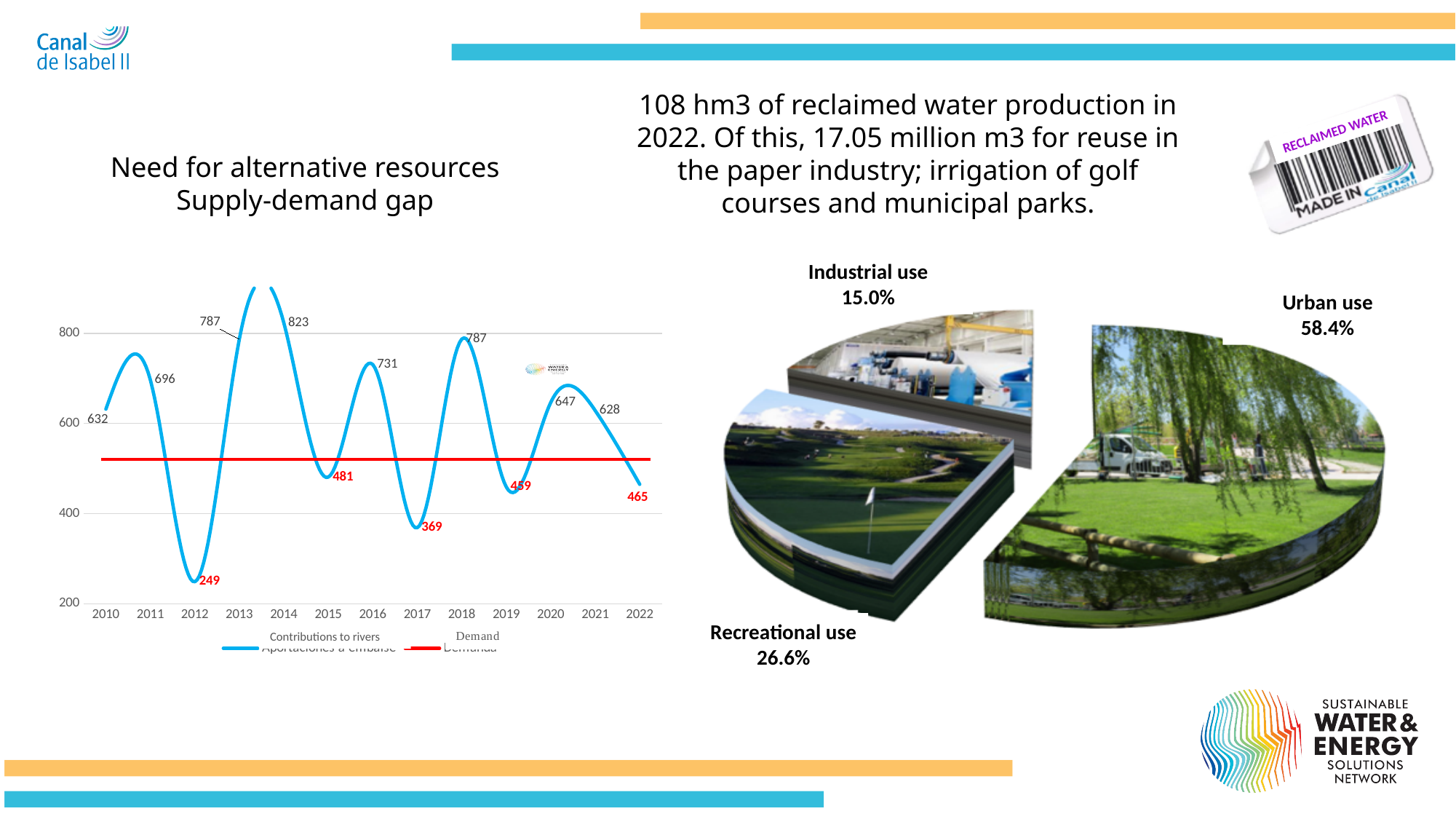
In the line chart on the left, what is the difference between the values for 2014 and 2012? 574 In the line chart on the left, which year has the lowest value? 2012 What kind of chart is the chart on the left of the slide? line chart In the line chart on the left, which year has the larger value, 2016 or 2020? 2016 In the line chart on the left, which year has the highest value? 2014 In the line chart on the left, is the Demand line greater or less than 600? less How many years are shown on the x axis of the line chart on the left? 13 In the line chart on the left, what is the value for 2022? 465 In the pie chart on the right, which category has the largest share? Urban use In the line chart on the left, what is the value for 2014? 823 In the line chart on the left, what is the value for 2012? 249 In the pie chart on the right, what share does Recreational use have? 26.6%